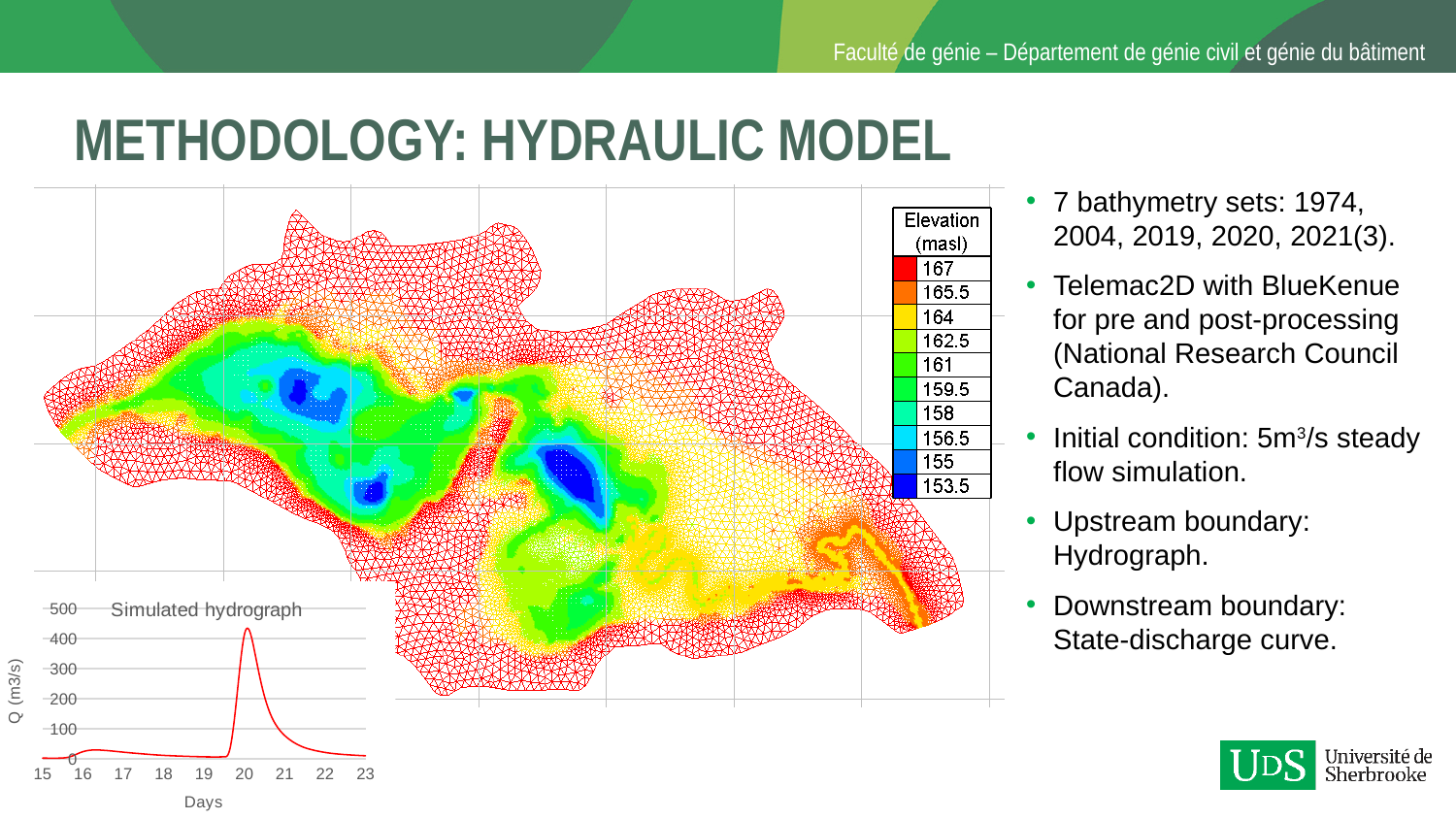
What is the label of the y axis on the Simulated hydrograph chart? Q (m3/s) On the Simulated hydrograph chart, is the discharge at day 22 greater or less than 100? less On the Simulated hydrograph chart, is the peak discharge value greater or less than 400? greater What kind of chart is the Simulated hydrograph? line chart On the Simulated hydrograph chart, does the discharge rise or fall between day 20 and day 23? fall On the Simulated hydrograph chart, is the discharge at day 17 greater or less than 100? less How many series are plotted on the Simulated hydrograph chart? 1 How many day tick labels are shown on the x axis of the Simulated hydrograph chart? 9 What is the title of the chart in the lower left of the slide? Simulated hydrograph On the Simulated hydrograph chart, which is larger: the discharge at day 20 or at day 16? day 20 On the Simulated hydrograph chart, around which day does the discharge reach its highest value? 20 On the Simulated hydrograph chart, does the discharge rise or fall between day 19 and day 20? rise